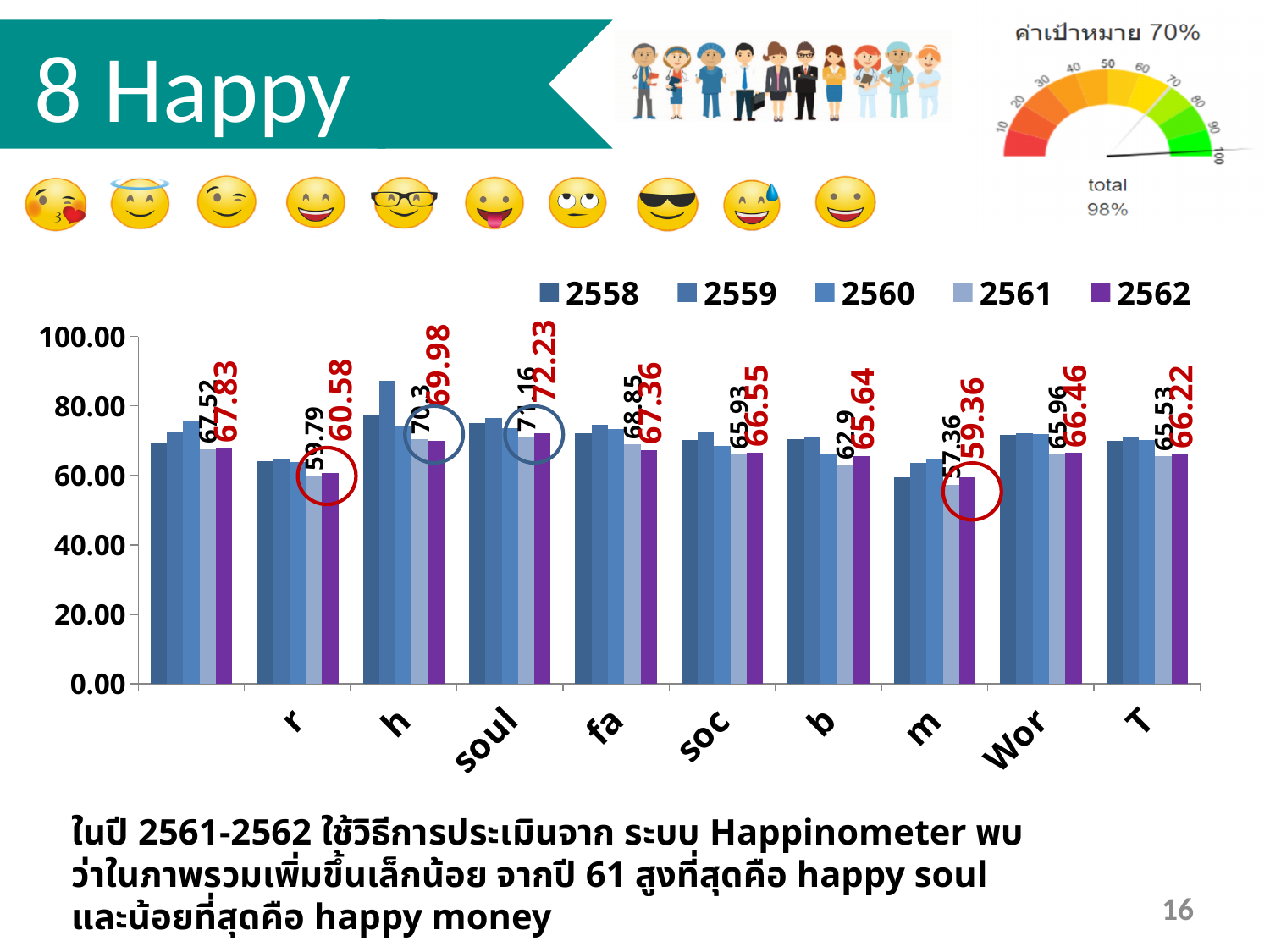
What is the 2562 value for soul? 72.23 How many series does the legend list? 5 Which category has the lowest 2562 value? m What is the difference between the 2562 and 2561 values for b? 2.74 What kind of chart is shown on the slide? bar chart Which category has the highest 2562 value? soul What is the 2562 value for T? 66.22 Is the 2558 value for h greater or less than 80? less What is the difference between the 2562 and 2561 values for soul? 1.07 Is the 2559 value for r greater or less than 80? less Which is larger, the 2562 value for h or the 2562 value for fa? h What is the 2561 value for m? 57.36